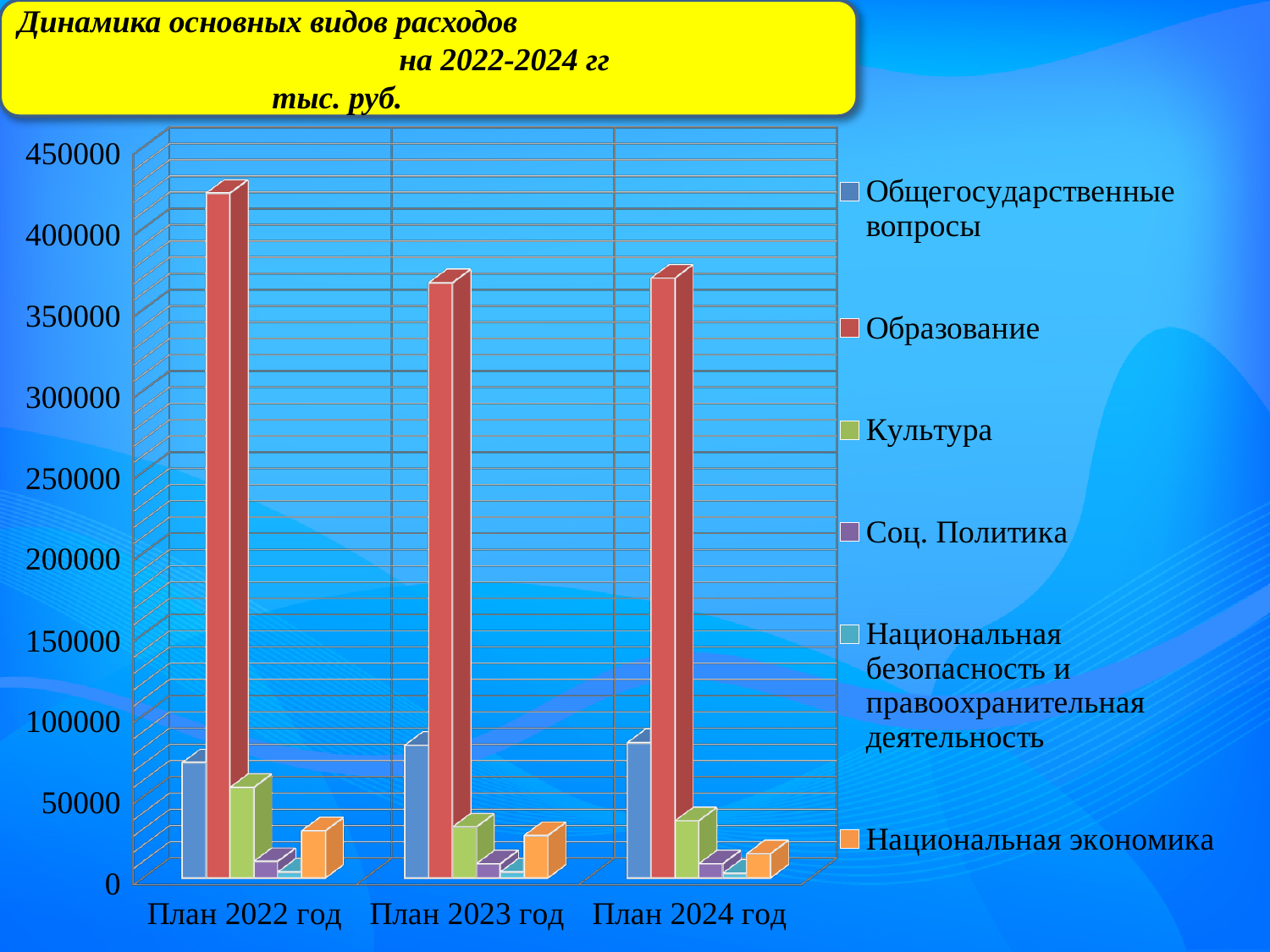
Which series has the highest value in План 2022 год? Образование Which is larger in План 2023 год: Образование or Общегосударственные вопросы? Образование What kind of chart is shown on the slide? bar chart Which series has the lowest value in План 2022 год? Национальная безопасность и правоохранительная деятельность How many categories (years) are shown on the x axis? 3 Is the value for Общегосударственные вопросы in План 2022 год greater or less than 100000? less How many series does the legend list? 6 Is the value for Образование in План 2023 год greater or less than 400000? less Does the value for Образование rise or fall from План 2022 год to План 2023 год? fall Is the value for Образование in План 2022 год greater or less than 400000? greater In which year is the value for Образование the highest? План 2022 год What colour represents Образование in the legend? red